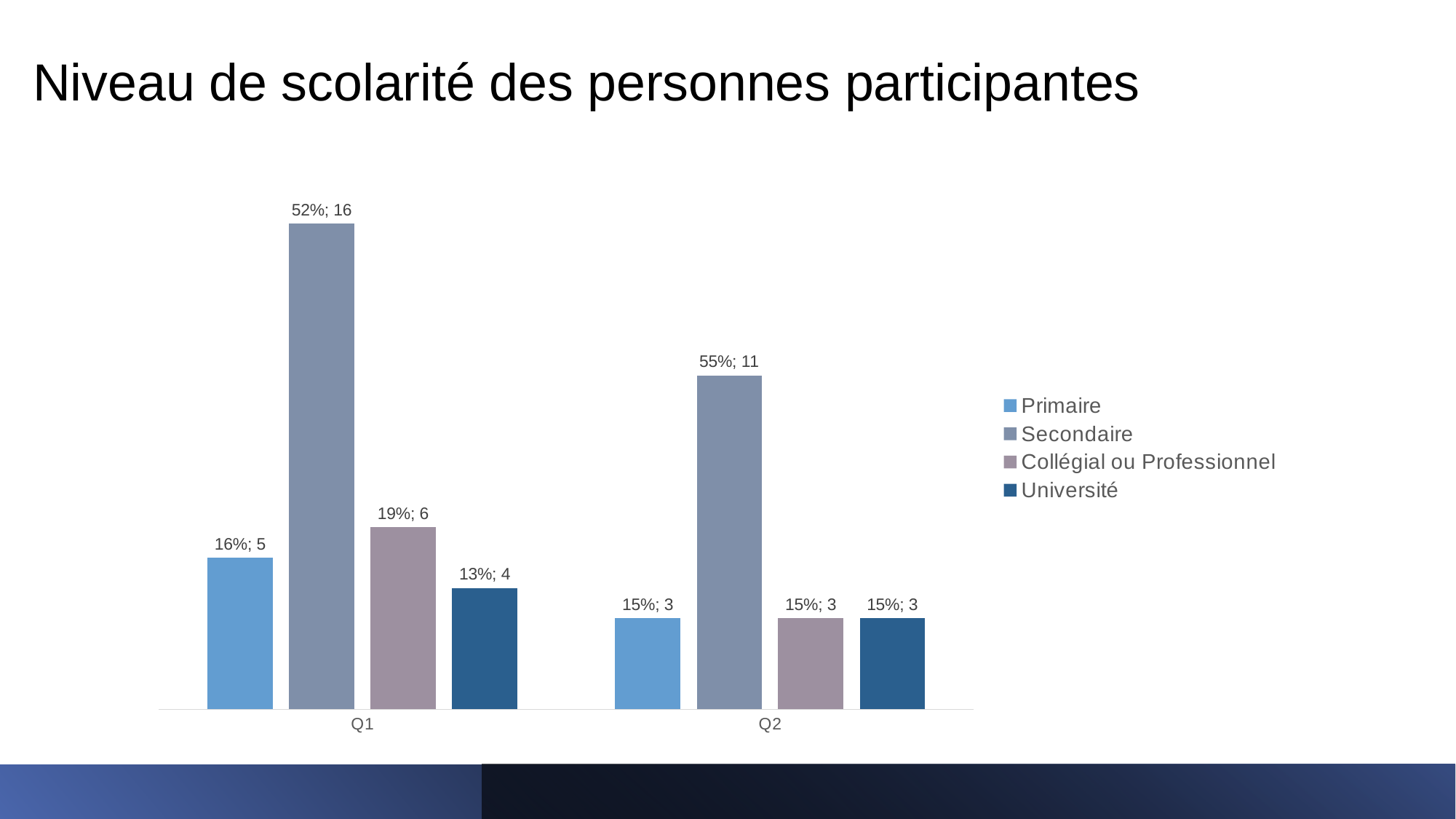
Which series has the lowest bar in Q1? Université How many more participants does the Secondaire bar show in Q1 than in Q2? 5 How many categories are shown on the x axis? 2 What is the data label shown on the Université bar for Q2? 15%; 3 What is the data label shown on the Primaire bar for Q2? 15%; 3 What is the title of the slide? Niveau de scolarité des personnes participantes How many series does the legend list? 4 What is the data label shown on the Collégial ou Professionnel bar for Q1? 19%; 6 What kind of chart is shown on the slide? Bar chart Which series has the highest bar in Q1? Secondaire Which is larger: the Collégial ou Professionnel bar in Q1 or the Université bar in Q1? Collégial ou Professionnel in Q1 What is the data label shown on the Secondaire bar for Q1? 52%; 16